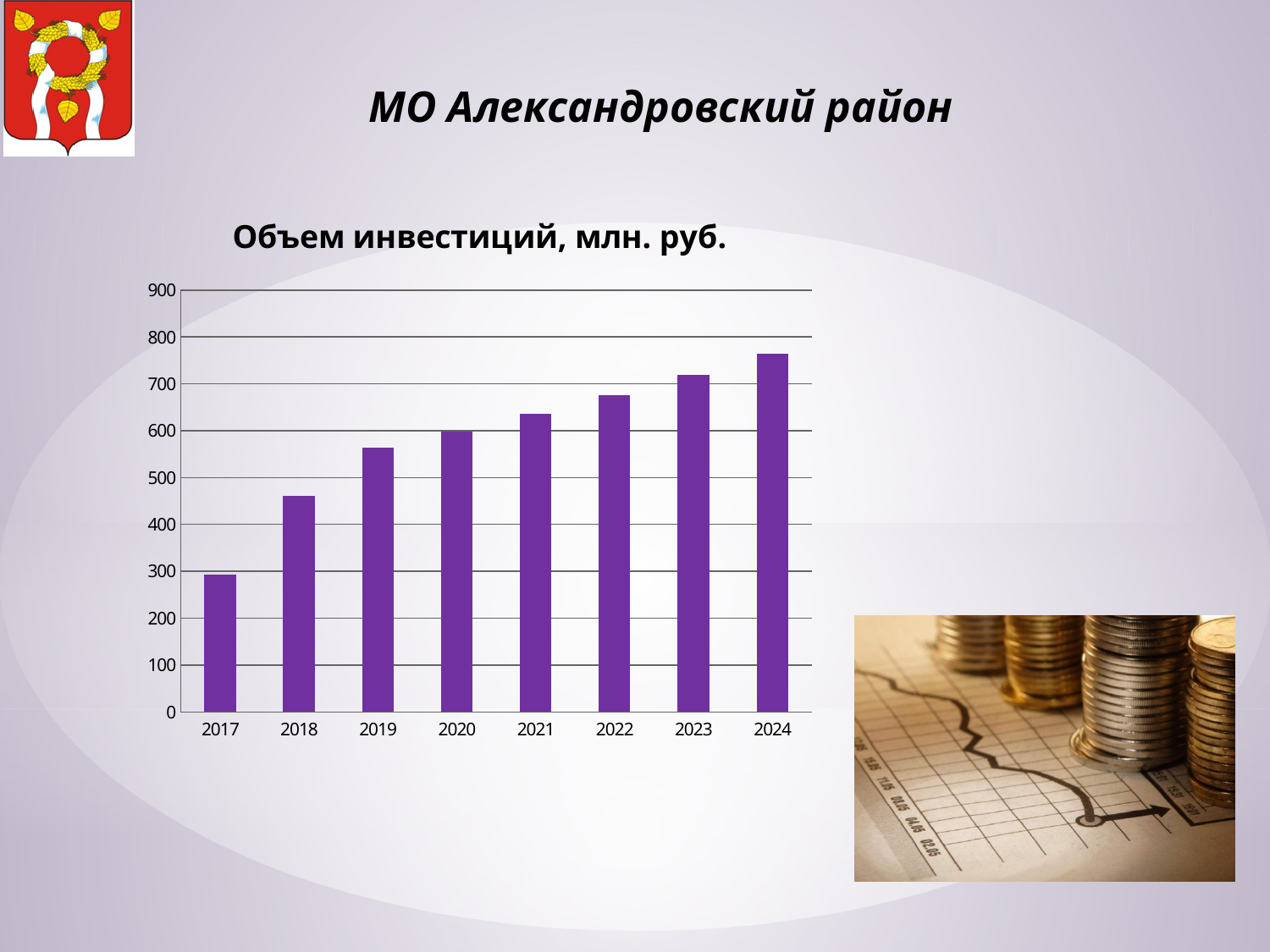
Which is larger, the value for 2019 or the value for 2022? 2022 What colour are the bars in the chart? purple What type of chart is shown on the slide? bar chart Is the value for 2023 greater or less than 700? greater Is the value for 2018 greater or less than 400? greater Is the value for 2024 greater or less than 800? less Which year has the lowest investment volume? 2017 What is the title of the chart? Объем инвестиций, млн. руб. Do the values rise or fall from 2017 to 2024? rise How many years are shown on the x axis of the chart? 8 Which year has the highest investment volume? 2024